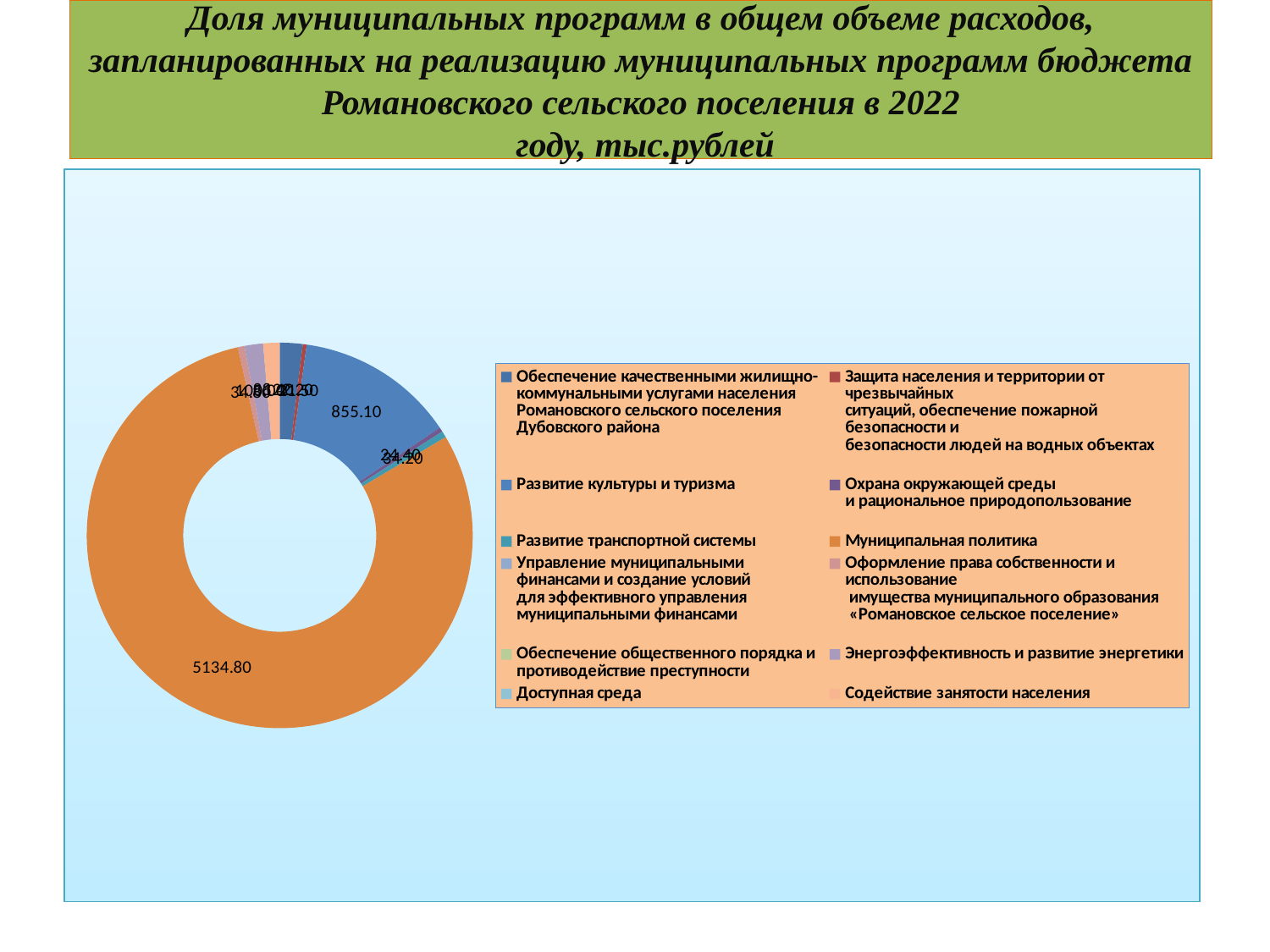
What kind of chart is shown on the slide? doughnut chart Is the value for Обеспечение качественными жилищно-коммунальными услугами населения greater or less than 1000? less In what units are the values on the chart given, according to the slide title? тыс.рублей Which category has the largest slice of the doughnut? Муниципальная политика What is the value for Муниципальная политика? 5134.80 Is the value for Муниципальная политика greater or less than 5000? greater What is the value for Обеспечение качественными жилищно-коммунальными услугами населения Романовского сельского поселения Дубовского района? 122.20 What colour is the slice for Муниципальная политика? orange Which is larger: the value for Муниципальная политика or the value for Обеспечение качественными жилищно-коммунальными услугами населения? Муниципальная политика How many entries does the legend list? 12